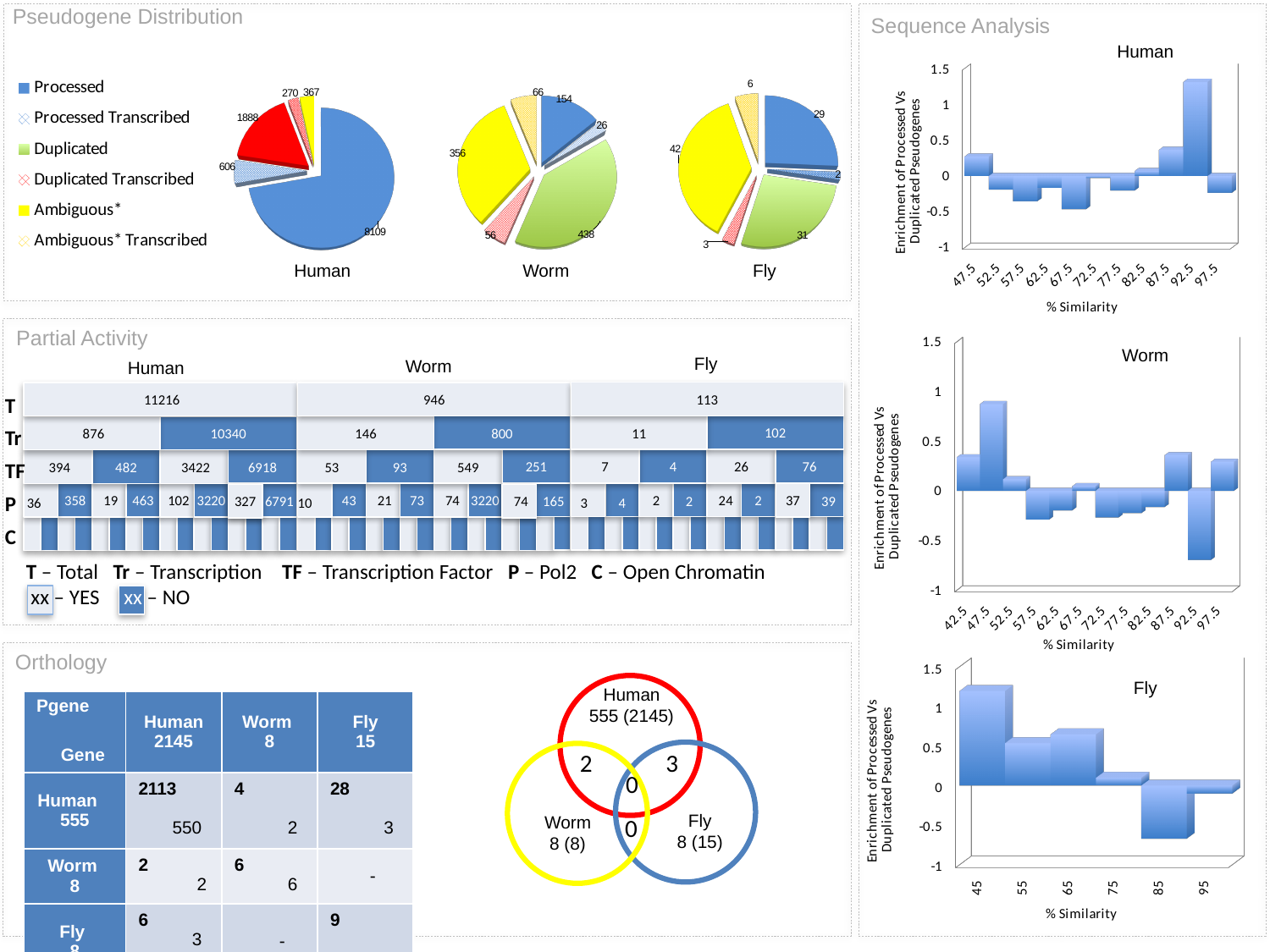
How many categories does the Pseudogene Distribution legend list? 6 In the Pseudogene Distribution Human pie chart, what is the value of the largest slice? 8109 In the Pseudogene Distribution Fly pie chart, what is the value for Processed? 29 In the Sequence Analysis Human chart, at which % Similarity is the enrichment highest? 92.5 In the Pseudogene Distribution Fly pie chart, what is the value for Ambiguous*? 42 In the Pseudogene Distribution Worm pie chart, what is the value for Ambiguous*? 356 How many % Similarity categories are shown on the x axis of the Sequence Analysis Fly chart? 6 In the Pseudogene Distribution Fly pie chart, what is the difference between the Duplicated value and the Processed value? 2 In the Sequence Analysis Fly chart, is the enrichment value at 45% similarity greater or less than 1? greater In the Pseudogene Distribution Worm pie chart, what is the value for Duplicated? 438 In the Sequence Analysis Worm chart, at which % Similarity is the enrichment lowest? 92.5 In the Pseudogene Distribution Worm pie chart, which is larger, Processed or Ambiguous*? Ambiguous*